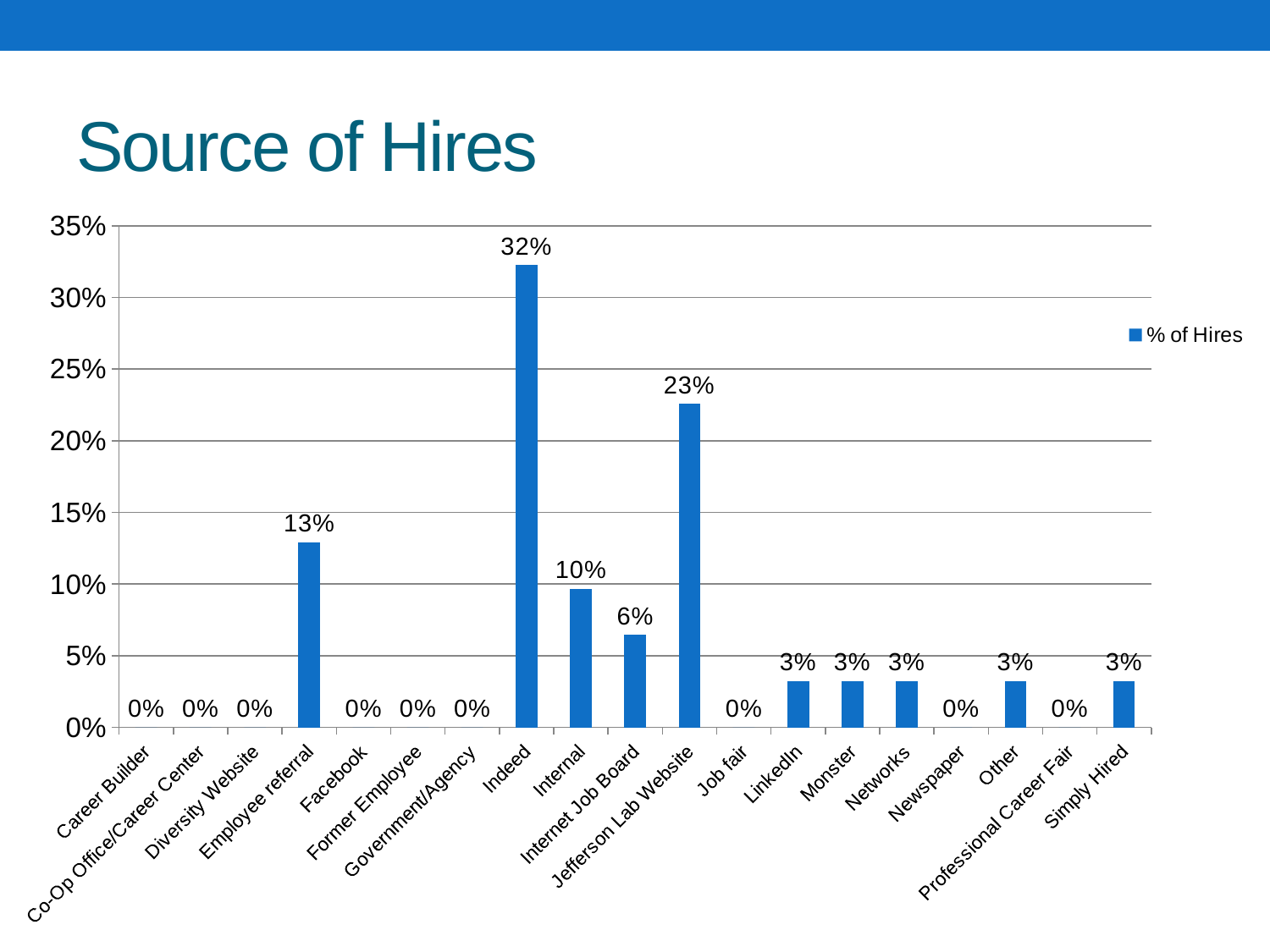
What is the title of the slide? Source of Hires What is the difference between the values for Indeed and Jefferson Lab Website? 9% What is the difference between the values for Employee referral and Internal? 3% What is the value for Internet Job Board? 6% Which source has the highest percentage of hires? Indeed Which is larger, the value for Internal or the value for LinkedIn? Internal What percentage of hires came from Indeed? 32% What kind of chart is shown on the slide? Bar chart How many source categories are shown on the x axis? 19 What percentage of hires came from Employee referral? 13% Is the value for Jefferson Lab Website greater or less than 20%? greater What is the value for Jefferson Lab Website? 23%